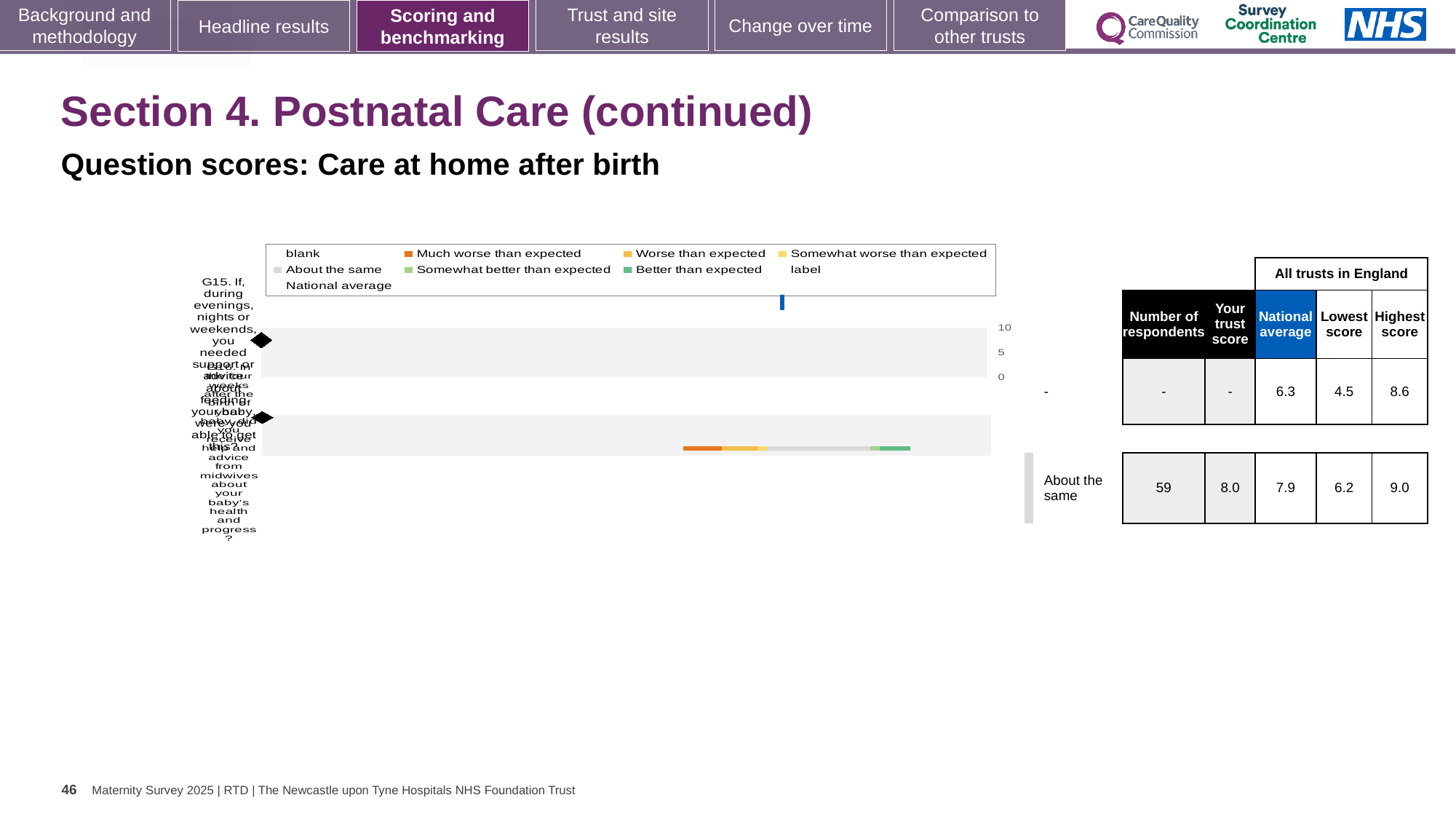
In the table beside the chart, what is the number of respondents for the row rated 'About the same'? 59 What colour is the legend entry 'Better than expected' in the chart? green In the table beside the chart, what is the lowest score for the first (top) row? 4.5 For the row rated 'About the same', what is the difference between the highest score and the lowest score? 2.8 In the table beside the chart, what is 'Your trust score' for the row rated 'About the same'? 8.0 In the table beside the chart, what is the national average for the row rated 'About the same'? 7.9 What kind of chart is shown on the slide? bar chart For the row rated 'About the same', which is larger: your trust score or the national average? Your trust score What colour is the legend entry 'Much worse than expected' in the chart? orange How many question rows (bars) does the chart contain? 2 In the table beside the chart, what is the highest score for the first (top) row? 8.6 In the table beside the chart, what is the national average for the first (top) row? 6.3